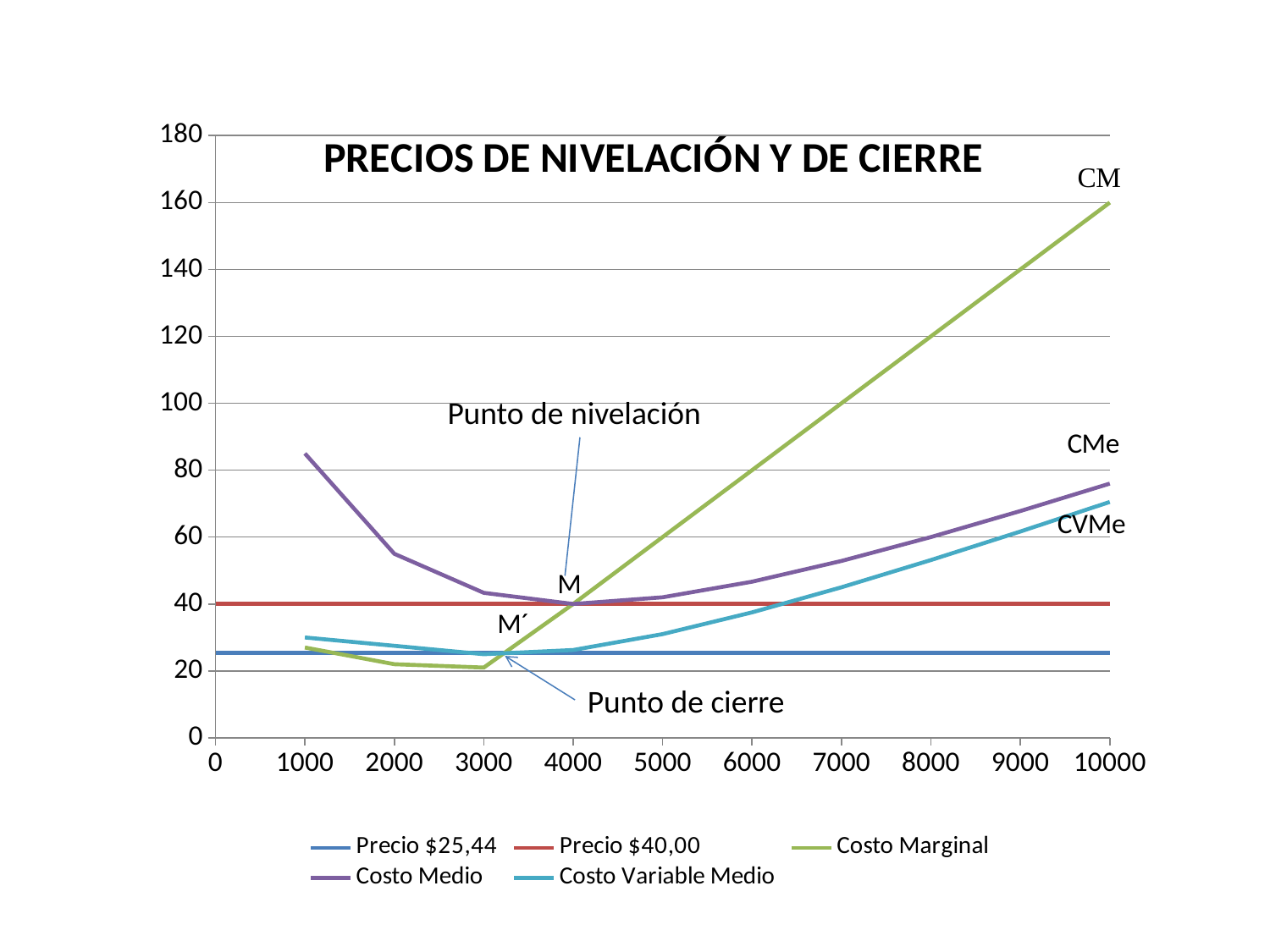
How many series does the legend list? 5 What kind of chart is shown on the slide? line chart Is the value of Costo Medio at 1000 greater or less than 80? greater Which series has the lowest value at 10000 on the x axis? Precio $25,44 Which series has the highest value at 10000 on the x axis? Costo Marginal Does the Costo Marginal line rise or fall between 3000 and 10000 on the x axis? rise Is the value of Costo Marginal at 2000 greater or less than 40? less Is the value of Costo Marginal at 10000 greater or less than 140? greater What label is attached to the point where the Costo Marginal line crosses the Costo Variable Medio line? Punto de cierre At 1000 on the x axis, which is larger: Costo Medio or Costo Variable Medio? Costo Medio What is the title of the chart? PRECIOS DE NIVELACIÓN Y DE CIERRE